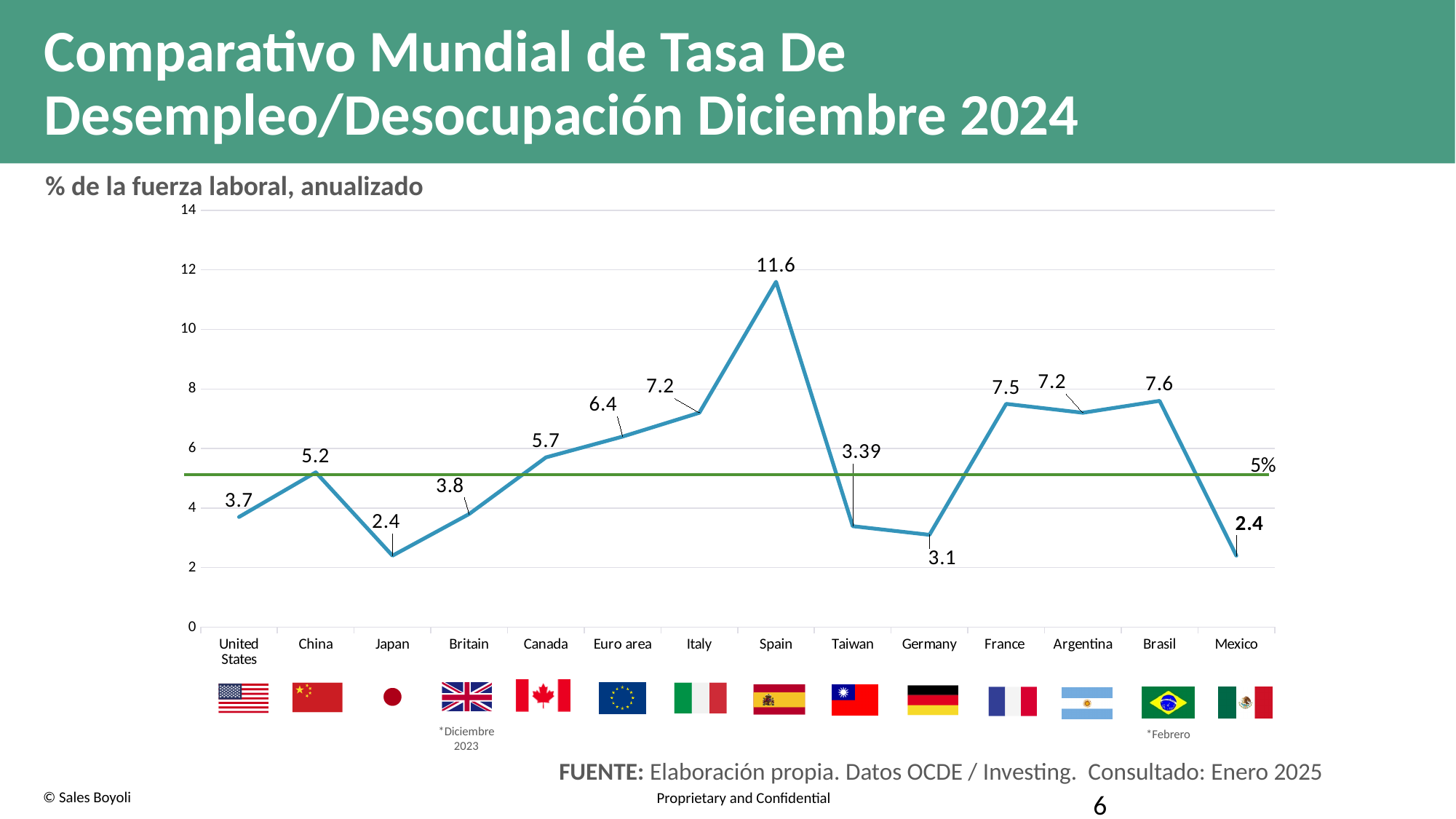
What is the unemployment rate shown for Spain? 11.6 What kind of chart is shown on the slide? Line chart What is the value shown for Euro area? 6.4 How many countries or regions are plotted on the chart? 14 Is the value for Mexico greater or less than 4? less Which country has the highest unemployment rate on the chart? Spain What value does the horizontal green reference line mark? 5% Which is larger, the value for France or the value for Canada? France What is the value plotted for Taiwan? 3.39 What is the difference between the values for Brasil and Germany? 4.5 Does the line rise or fall from Spain to Taiwan? Fall What is the difference between the values for Spain and Italy? 4.4